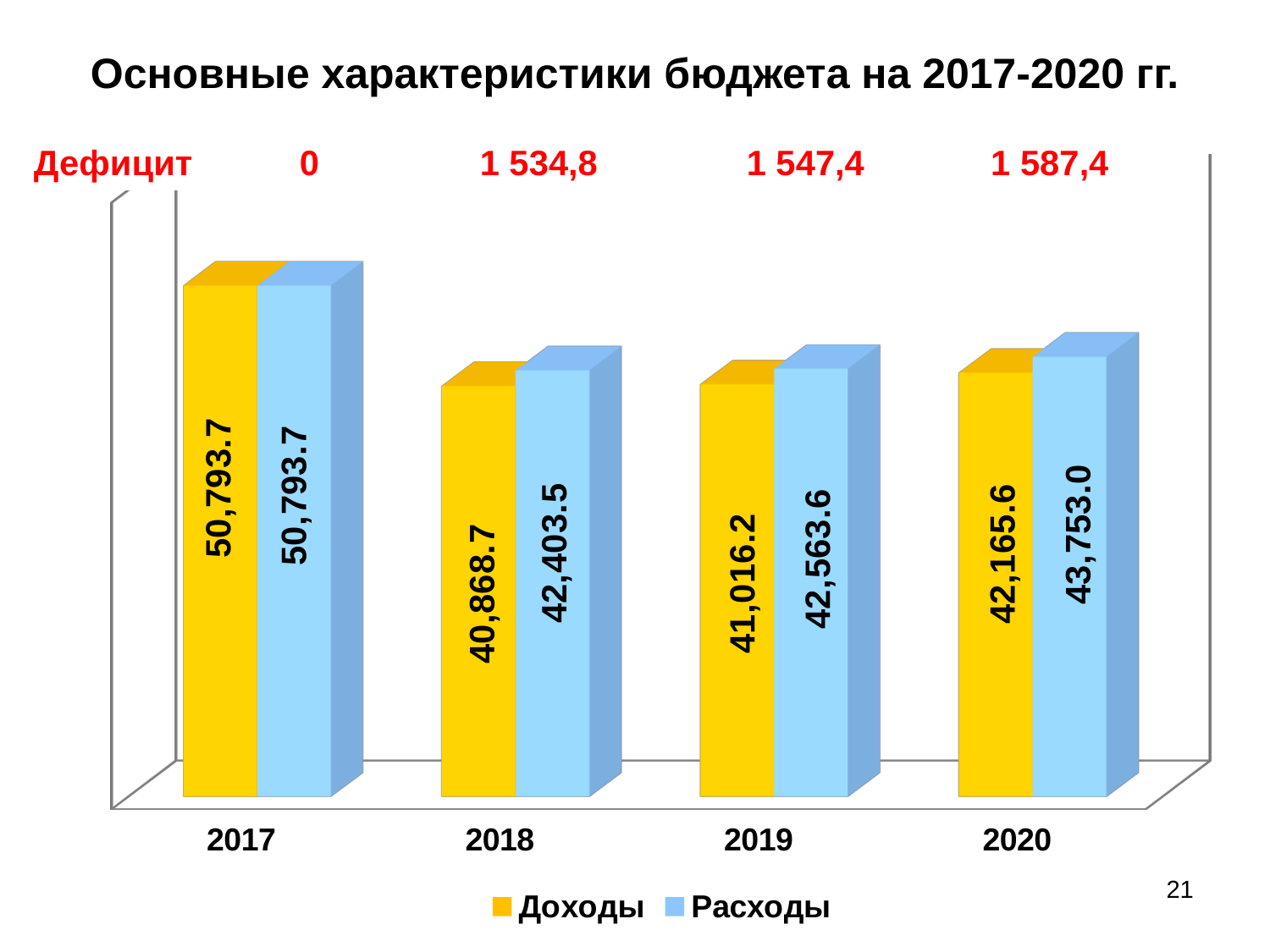
How many years are shown on the x axis? 4 What is the value of Доходы for 2019? 41,016.2 Which is larger in 2019, Доходы or Расходы? Расходы What is the value of Доходы for 2017? 50,793.7 What is the value of Расходы for 2018? 42,403.5 Which year has the lowest value for Доходы? 2018 Which year has the highest value for Расходы? 2017 What is the value of Расходы for 2020? 43,753.0 What is the difference between Расходы and Доходы in 2018? 1,534.8 What is the difference between Расходы and Доходы in 2020? 1,587.4 How many series does the legend list? 2 What kind of chart is shown on the slide? Bar chart